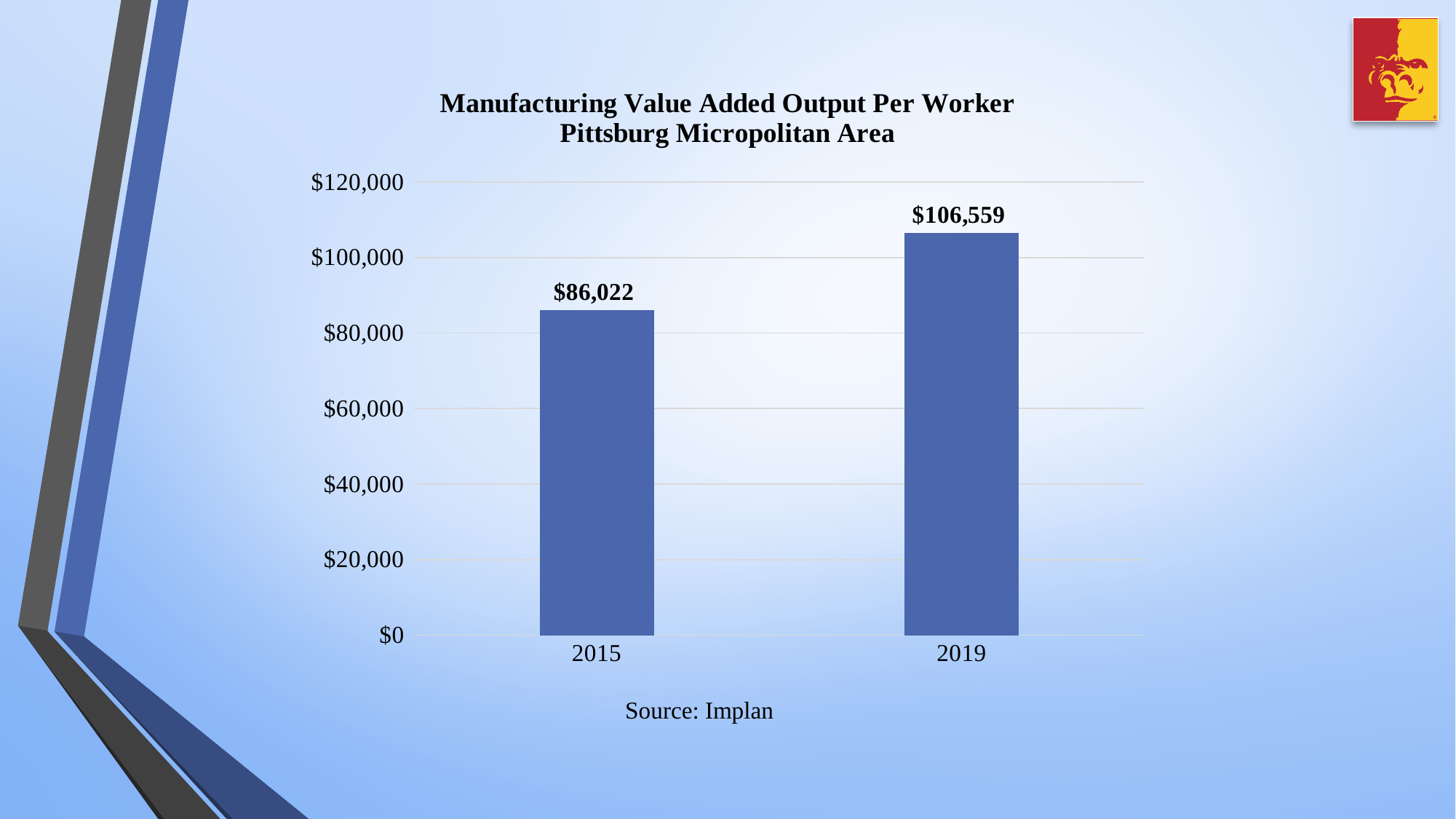
What is the manufacturing value added output per worker for 2015? $86,022 What is the manufacturing value added output per worker for 2019? $106,559 Does the value rise or fall from 2015 to 2019? rise What is the title of the chart? Manufacturing Value Added Output Per Worker Pittsburg Micropolitan Area What is the difference between the 2019 and 2015 values? $20,537 How many years are shown on the chart? 2 Is the value for 2019 greater or less than $100,000? greater Which year has the higher value added output per worker? 2019 What source is cited below the chart? Implan Which year has the lower value added output per worker? 2015 Is the value for 2015 greater or less than $100,000? less What kind of chart is shown on the slide? bar chart